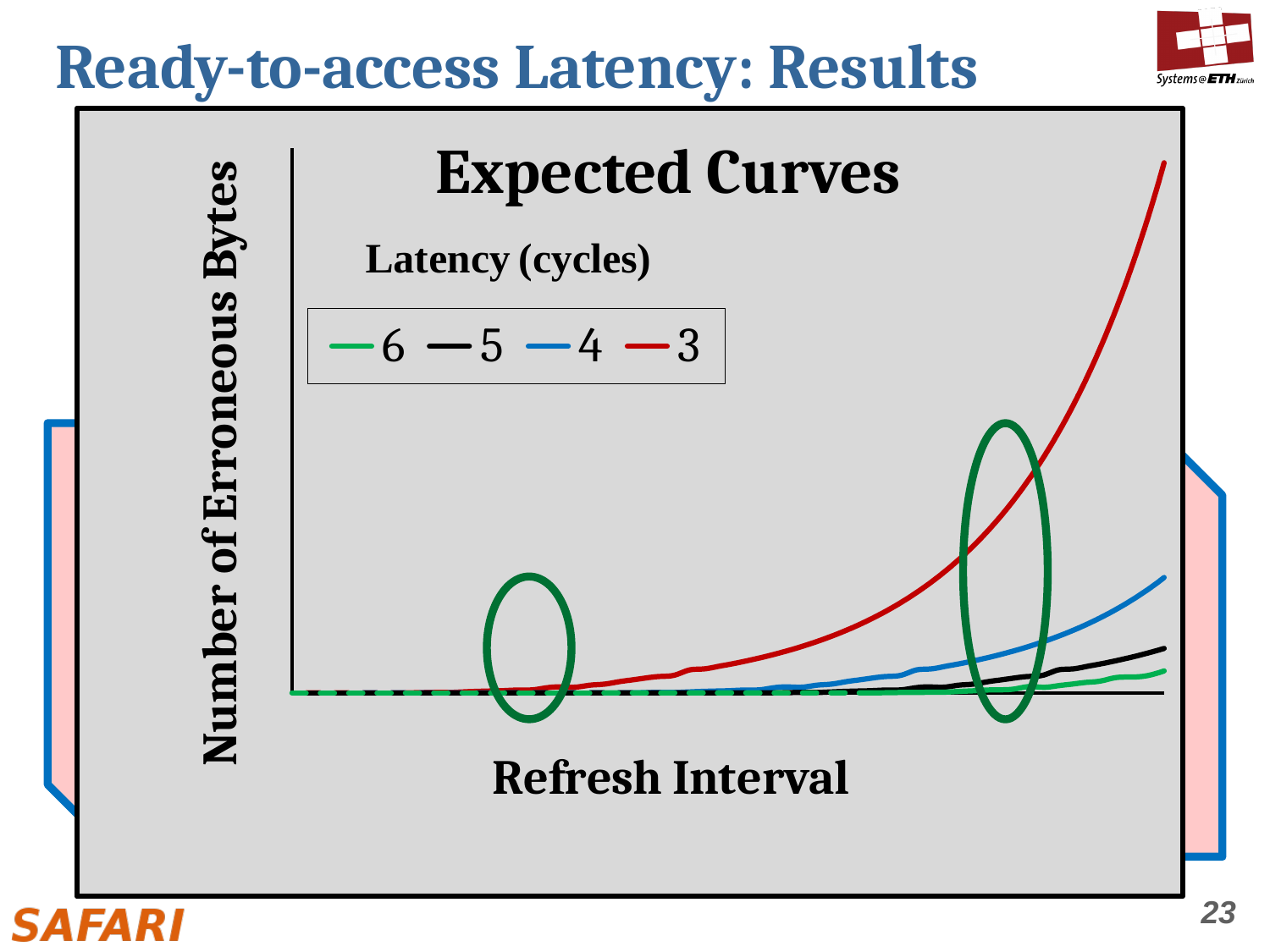
What kind of chart is shown on the slide? line chart What is the label of the x axis of the chart? Refresh Interval At the right end of the x axis, which series is higher: latency 4 or latency 5? 4 Do the curves rise or fall as the refresh interval increases along the x axis? rise What is the title of the chart? Expected Curves At the right end of the x axis, which series is higher: latency 3 or latency 4? 3 Which series stays lowest at the right end of the x axis? 6 How many series does the legend of the chart list? 4 Which series reaches the highest number of erroneous bytes at the right end of the x axis? 3 Which series in the legend is drawn in red? 3